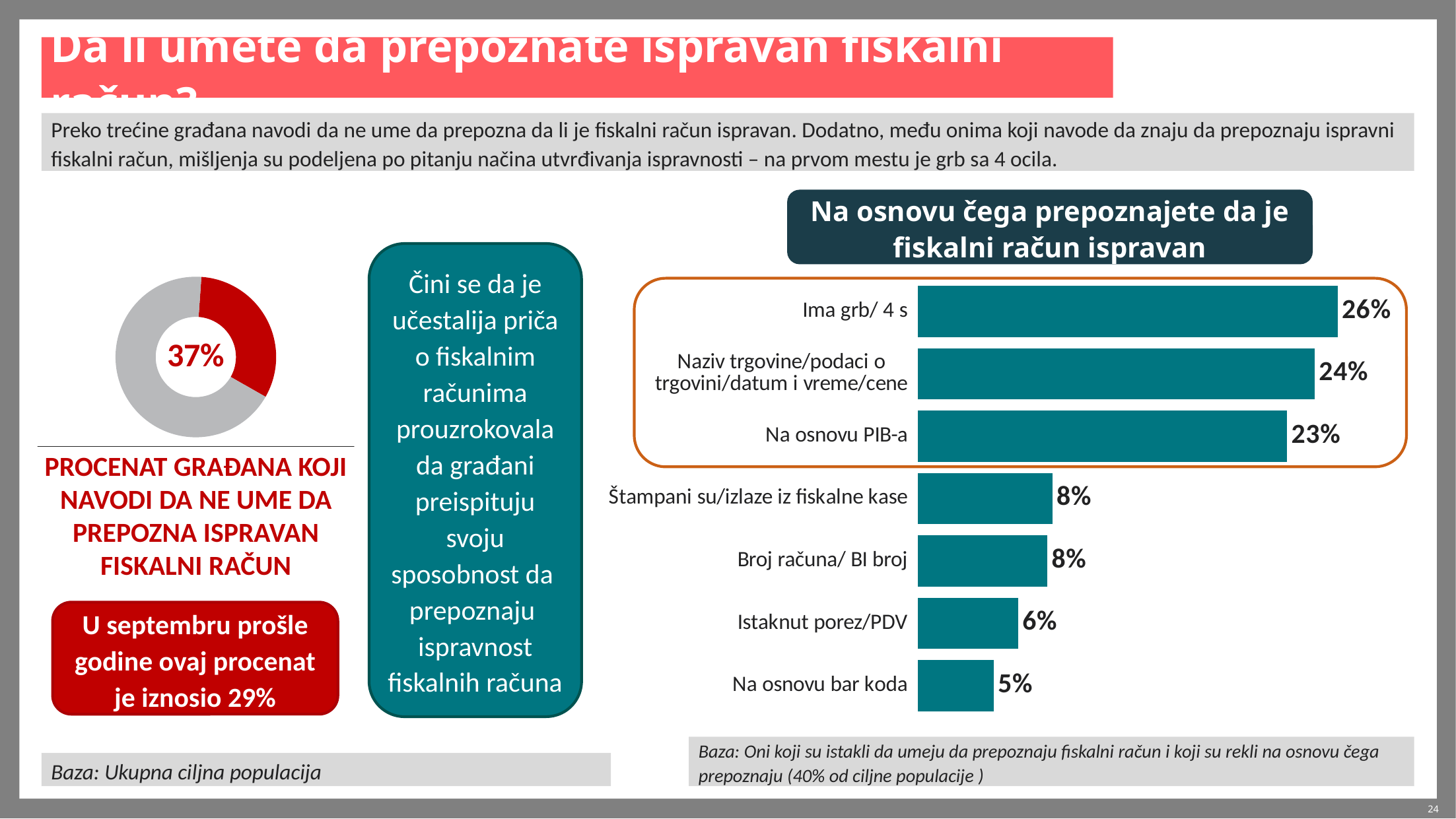
In the bar chart 'Na osnovu čega prepoznajete da je fiskalni račun ispravan', which is larger: 'Štampani su/izlaze iz fiskalne kase' or 'Istaknut porez/PDV'? Štampani su/izlaze iz fiskalne kase How many categories are shown in the bar chart 'Na osnovu čega prepoznajete da je fiskalni račun ispravan'? 7 In the bar chart 'Na osnovu čega prepoznajete da je fiskalni račun ispravan', what is the value for 'Istaknut porez/PDV'? 6% In the donut chart on the left of the slide, what percentage is shown in the centre? 37% In the bar chart 'Na osnovu čega prepoznajete da je fiskalni račun ispravan', what is the value for 'Ima grb/ 4 s'? 26% In the bar chart 'Na osnovu čega prepoznajete da je fiskalni račun ispravan', what is the difference between 'Naziv trgovine/podaci o trgovini/datum i vreme/cene' and 'Na osnovu PIB-a'? 1% In the bar chart 'Na osnovu čega prepoznajete da je fiskalni račun ispravan', what is the difference between 'Ima grb/ 4 s' and 'Na osnovu bar koda'? 21% In the bar chart 'Na osnovu čega prepoznajete da je fiskalni račun ispravan', which category has the highest value? Ima grb/ 4 s In the bar chart 'Na osnovu čega prepoznajete da je fiskalni račun ispravan', what is the value for 'Na osnovu PIB-a'? 23% What kind of chart is the chart on the left side of the slide showing 37%? Donut chart In the bar chart 'Na osnovu čega prepoznajete da je fiskalni račun ispravan', which category has the lowest value? Na osnovu bar koda What kind of chart is the chart on the right side of the slide, 'Na osnovu čega prepoznajete da je fiskalni račun ispravan'? Bar chart